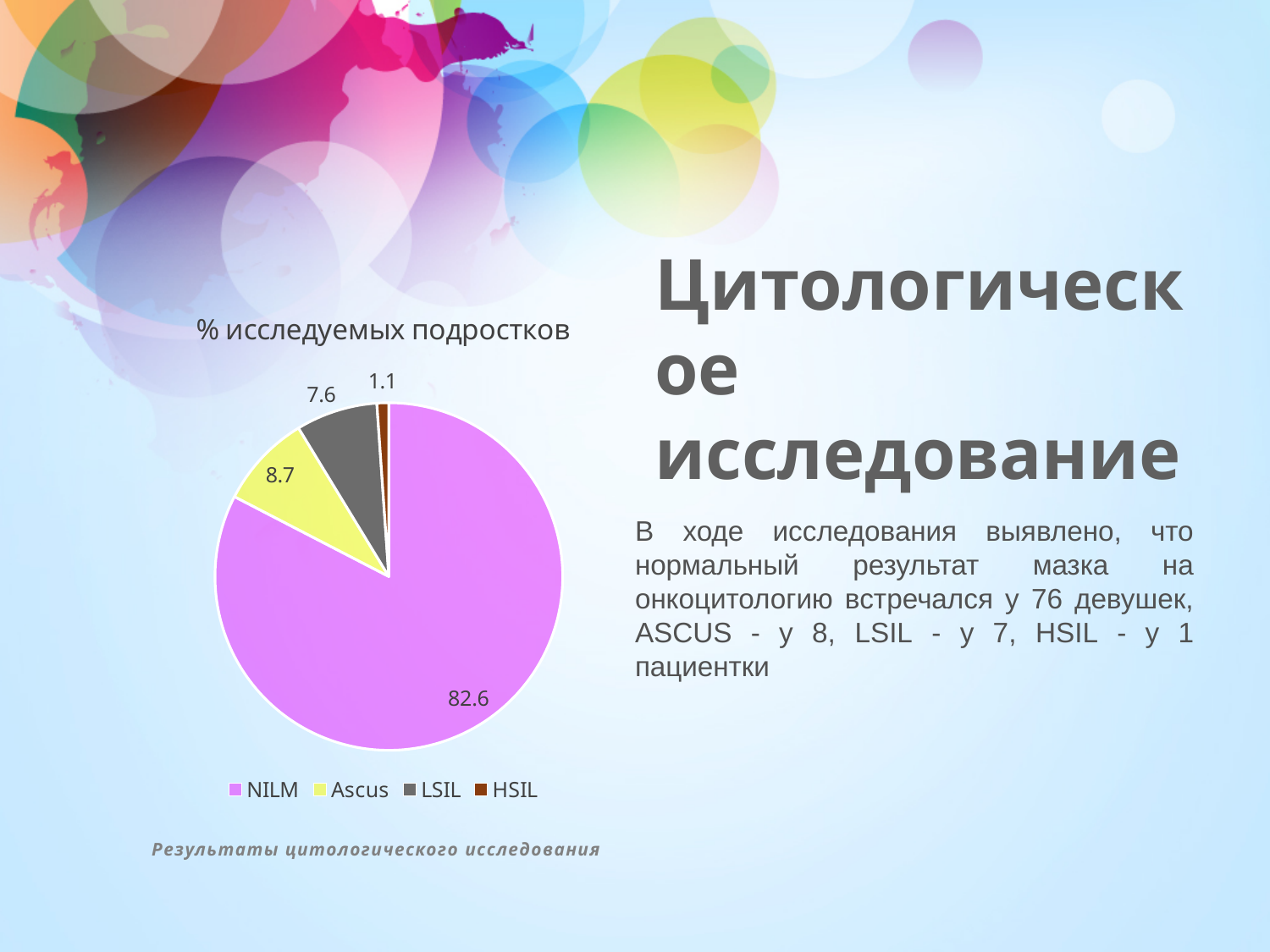
What colour is the NILM slice in the pie chart? pink What is the value for Ascus in the pie chart? 8.7 What is the difference between the values for Ascus and LSIL? 1.1 What kind of chart is shown on the slide? pie chart How many categories does the pie chart show? 4 Which category has the smallest slice of the pie chart? HSIL What is the value for LSIL in the pie chart? 7.6 Which is larger, the value for Ascus or the value for LSIL? Ascus What is the title of the pie chart? % исследуемых подростков Which category has the largest slice of the pie chart? NILM What is the value for NILM in the pie chart? 82.6 What is the value for HSIL in the pie chart? 1.1